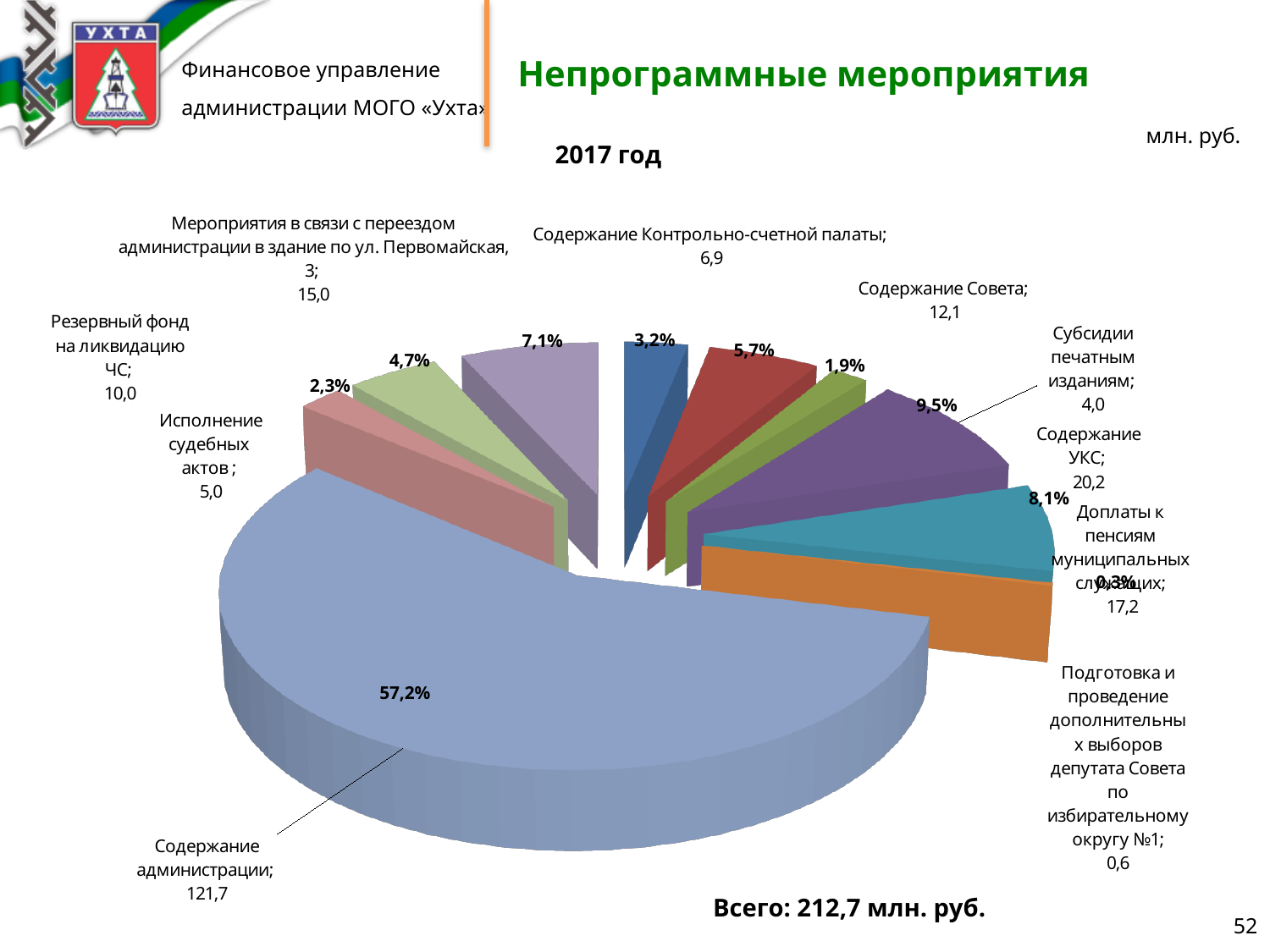
What share of the pie does «Содержание администрации» represent? 57,2% What is the value for «Содержание УКС»? 20,2 Which category has the smallest slice of the pie? Подготовка и проведение дополнительных выборов депутата Совета по избирательному округу №1 What is the difference between the values for «Содержание Совета» and «Резервный фонд на ликвидацию ЧС»? 2,1 Which is larger: the value for «Исполнение судебных актов» or «Субсидии печатным изданиям»? Исполнение судебных актов What is the value for «Содержание Контрольно-счетной палаты»? 6,9 What share of the pie does «Содержание УКС» represent? 9,5% What is the value for «Содержание администрации»? 121,7 Which category has the largest slice of the pie? Содержание администрации What is the value for «Доплаты к пенсиям муниципальных служащих»? 17,2 How many categories (slices) does the pie chart show? 10 What type of chart is shown on the slide? pie chart